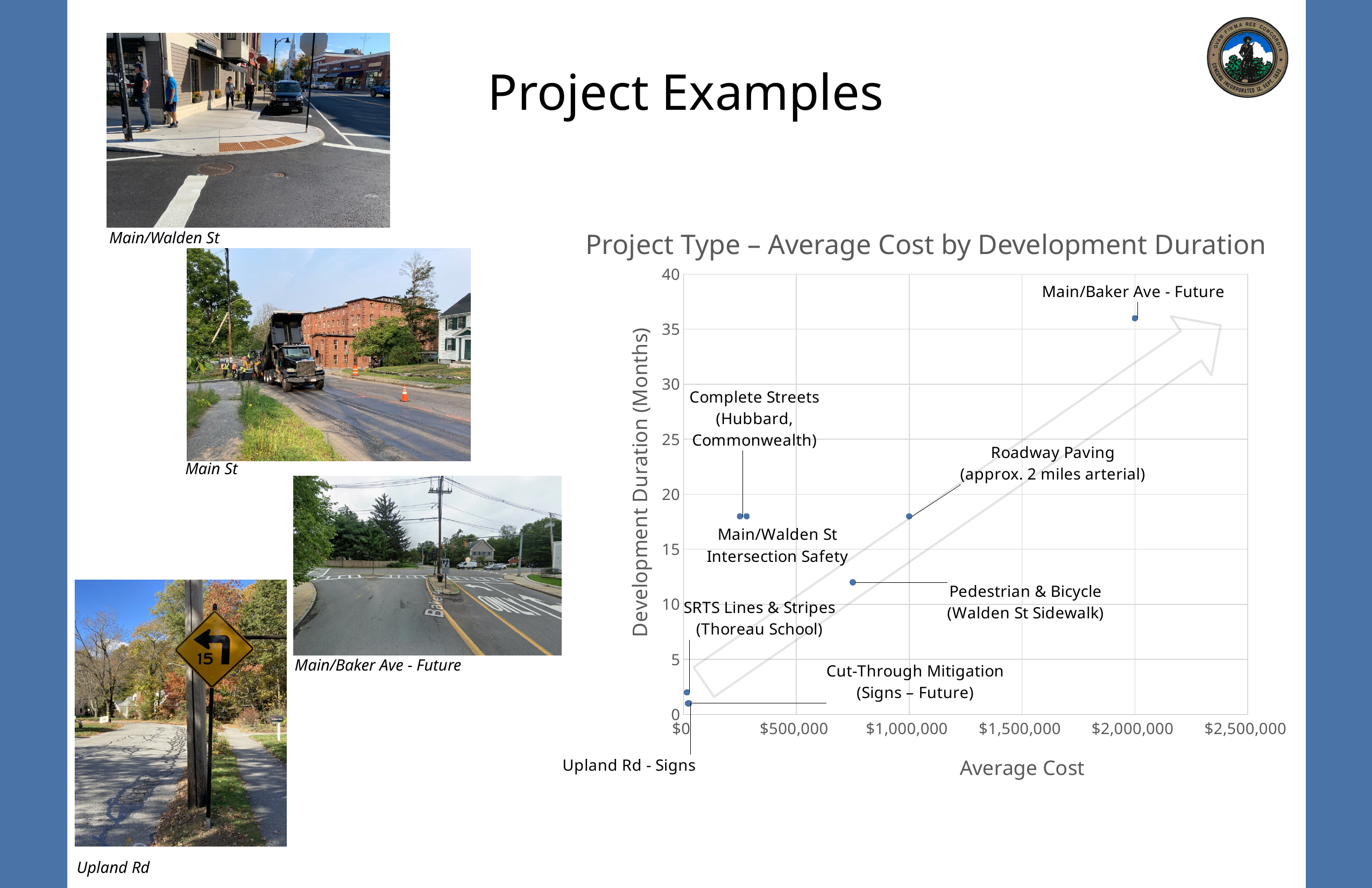
What is the average cost of the Main/Baker Ave - Future project? $2,000,000 How many labeled project points are plotted on the chart? 8 What is the title of the chart? Project Type – Average Cost by Development Duration As average cost increases along the x axis, does development duration generally rise or fall? Rise What is the label of the vertical axis of the chart? Development Duration (Months) Which project has the longest development duration? Main/Baker Ave - Future What kind of chart is shown on the slide? Scatter chart Is the development duration for Main/Baker Ave - Future greater or less than 30 months? greater What is the average cost of the Roadway Paving (approx. 2 miles arterial) project? $1,000,000 Which has a higher average cost, Roadway Paving or Pedestrian & Bicycle (Walden St Sidewalk)? Roadway Paving Which project has the highest average cost? Main/Baker Ave - Future Is the development duration for Pedestrian & Bicycle (Walden St Sidewalk) greater or less than 15 months? less